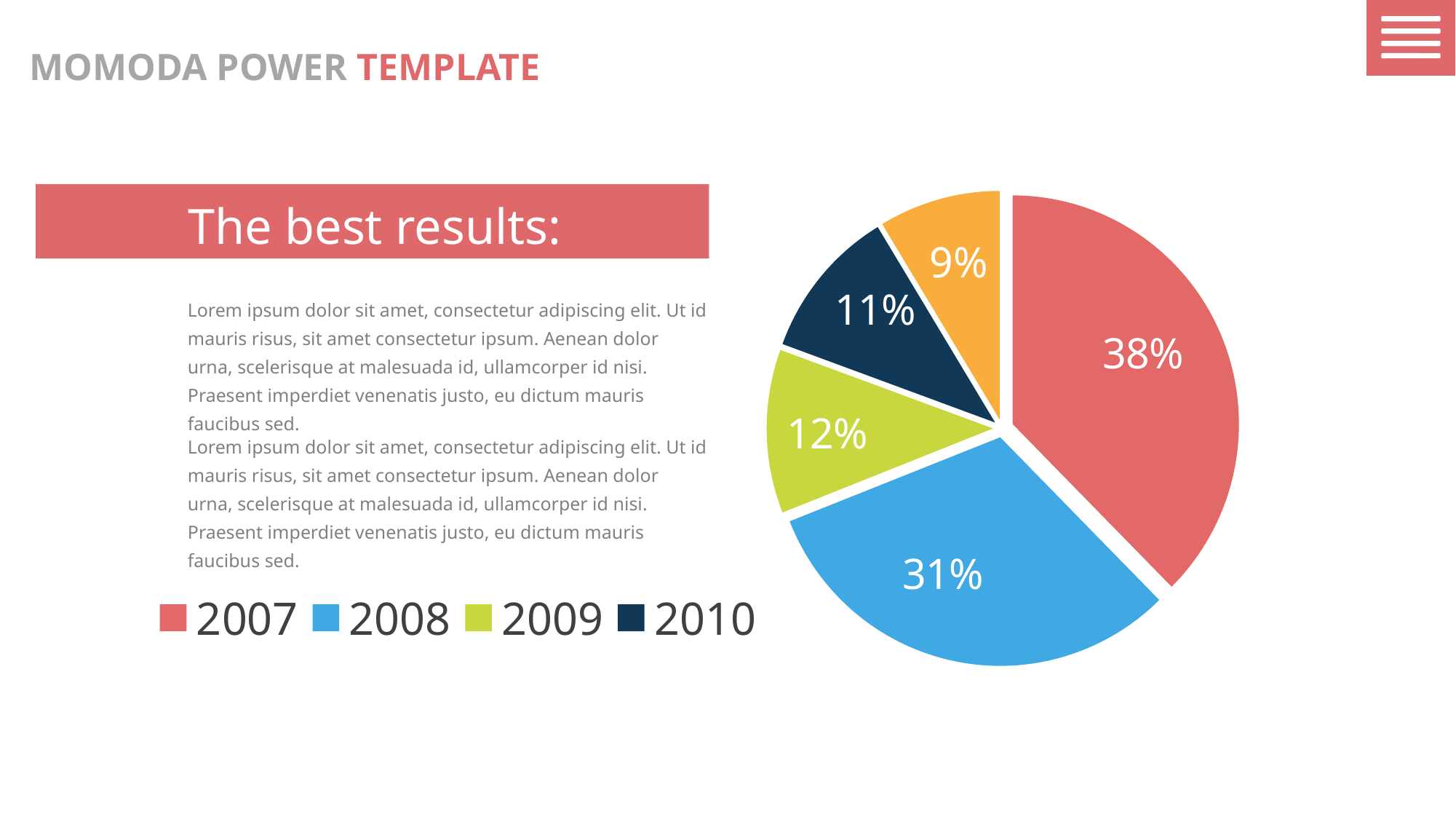
Which year has the largest slice of the pie chart? 2007 What percentage does the 2008 slice of the pie chart show? 31% Which slice is larger, 2009 or 2010? 2009 What percentage does the 2009 slice of the pie chart show? 12% How many entries does the legend list? 4 What is the percentage shown on the smallest slice of the pie chart? 9% What colour is the 2008 slice of the pie chart? blue What percentage does the 2010 slice of the pie chart show? 11% What is the difference in percentage points between the 2007 slice and the 2008 slice? 7 What kind of chart is shown on the slide? pie chart What percentage does the 2007 slice of the pie chart show? 38% How many slices does the pie chart have? 5